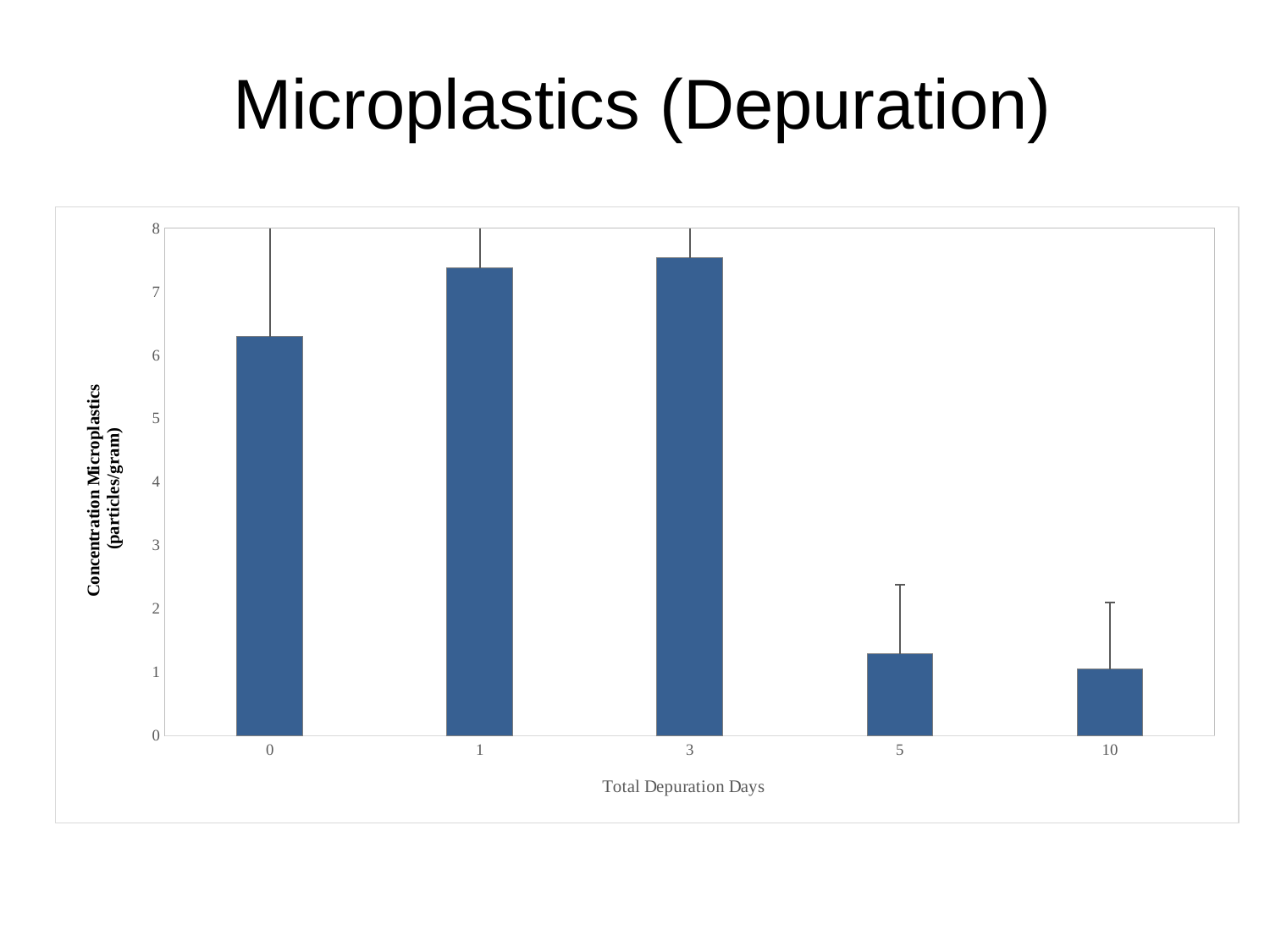
What is the title of the y axis of the chart? Concentration Microplastics (particles/gram) Which has the lower concentration of microplastics: 0 depuration days or 10 depuration days? 10 How many bars (depuration day categories) are plotted in the chart? 5 What is the title of the x axis of the chart? Total Depuration Days What kind of chart is shown on the slide? bar chart Is the value for 10 depuration days greater or less than 2? less Is the value for 0 depuration days greater or less than 6? greater Which has the higher concentration of microplastics: 3 depuration days or 5 depuration days? 3 Which has the higher concentration of microplastics: 0 depuration days or 1 depuration day? 1 Is the value for 3 depuration days greater or less than 7? greater